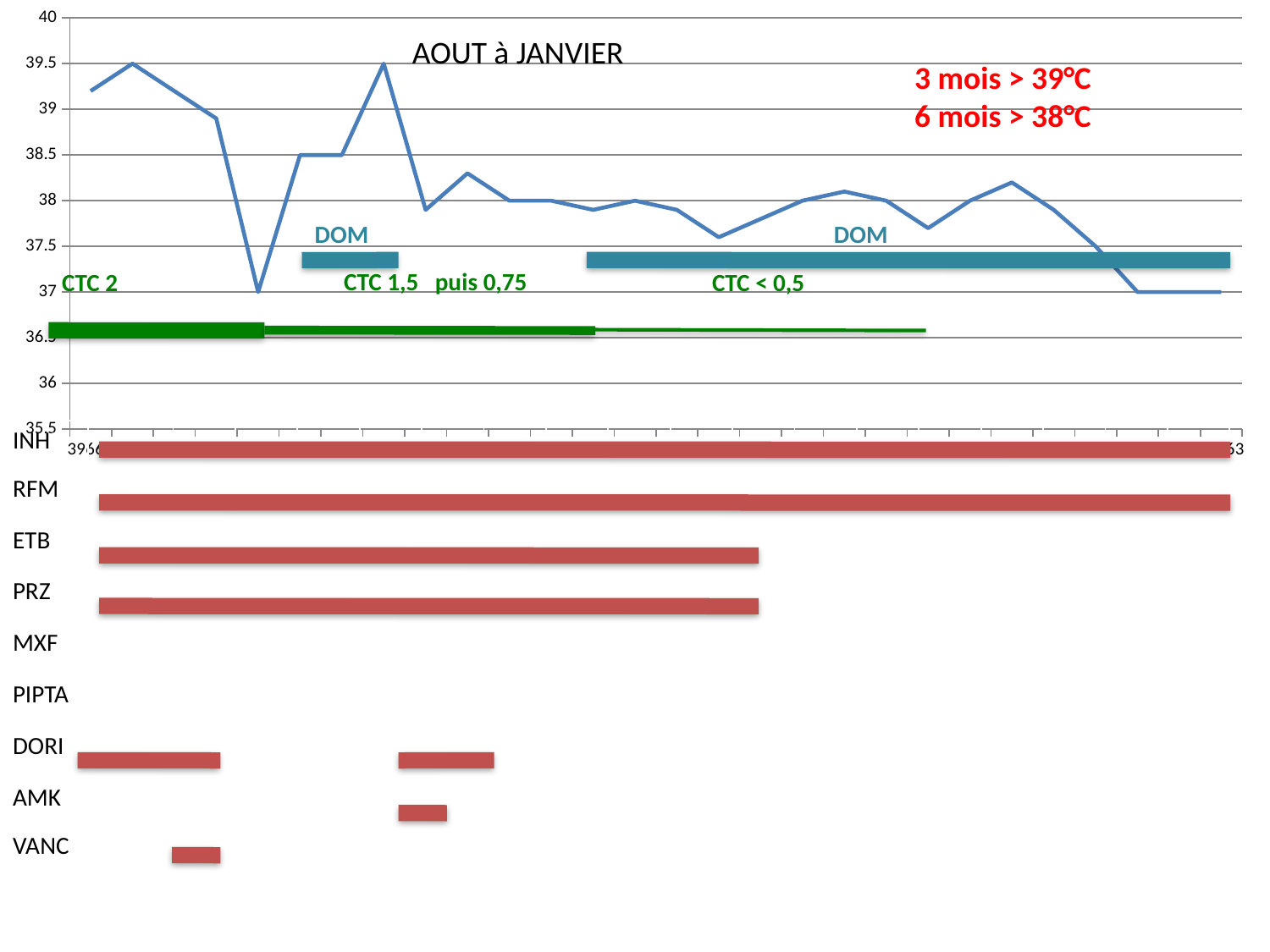
In the upper line chart, is the first plotted value greater or less than 39? greater In the upper line chart, does the temperature line overall rise or fall from left to right? fall In the lower timeline chart, which drugs have no bar drawn? MXF and PIPTA What is the title of the upper line chart? AOUT à JANVIER What is the highest value shown on the y axis of the upper line chart? 40 How many drug labels are listed in the lower timeline chart? 9 In the lower timeline chart, which drugs have bars spanning the full width of the timeline? INH and RFM What kind of chart is the upper chart on the slide? line chart How many blue bars labelled DOM are shown in the upper chart? 2 In the upper line chart, is the last plotted value greater or less than 37.5? less What is the highest temperature value reached by the line in the upper chart? 39.5 What is the lowest temperature value reached by the line in the upper chart? 37